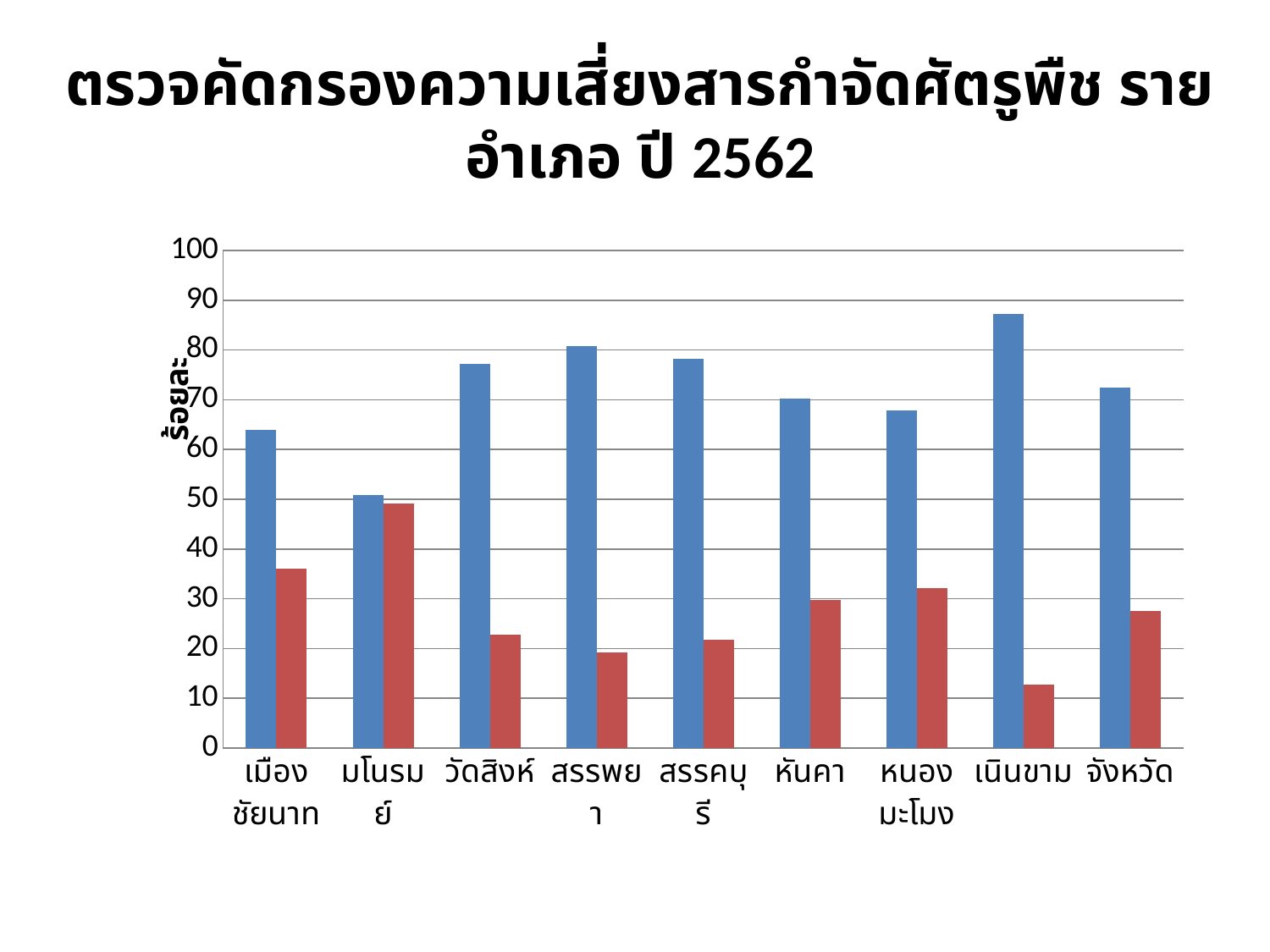
What is the label on the vertical axis? ร้อยละ Which category has the tallest red bar? มโนรมย์ Which is larger, the blue bar for เมืองชัยนาท or the blue bar for หันคา? หันคา Which category has the shortest blue bar? มโนรมย์ Which category has the shortest red bar? เนินขาม How many categories are shown along the x axis? 9 What kind of chart is shown on the slide? bar chart Is the blue bar for วัดสิงห์ greater or less than 70? greater Is the red bar for เนินขาม greater or less than 20? less Is the blue bar for เนินขาม greater or less than 80? greater Which category has the tallest blue bar? เนินขาม